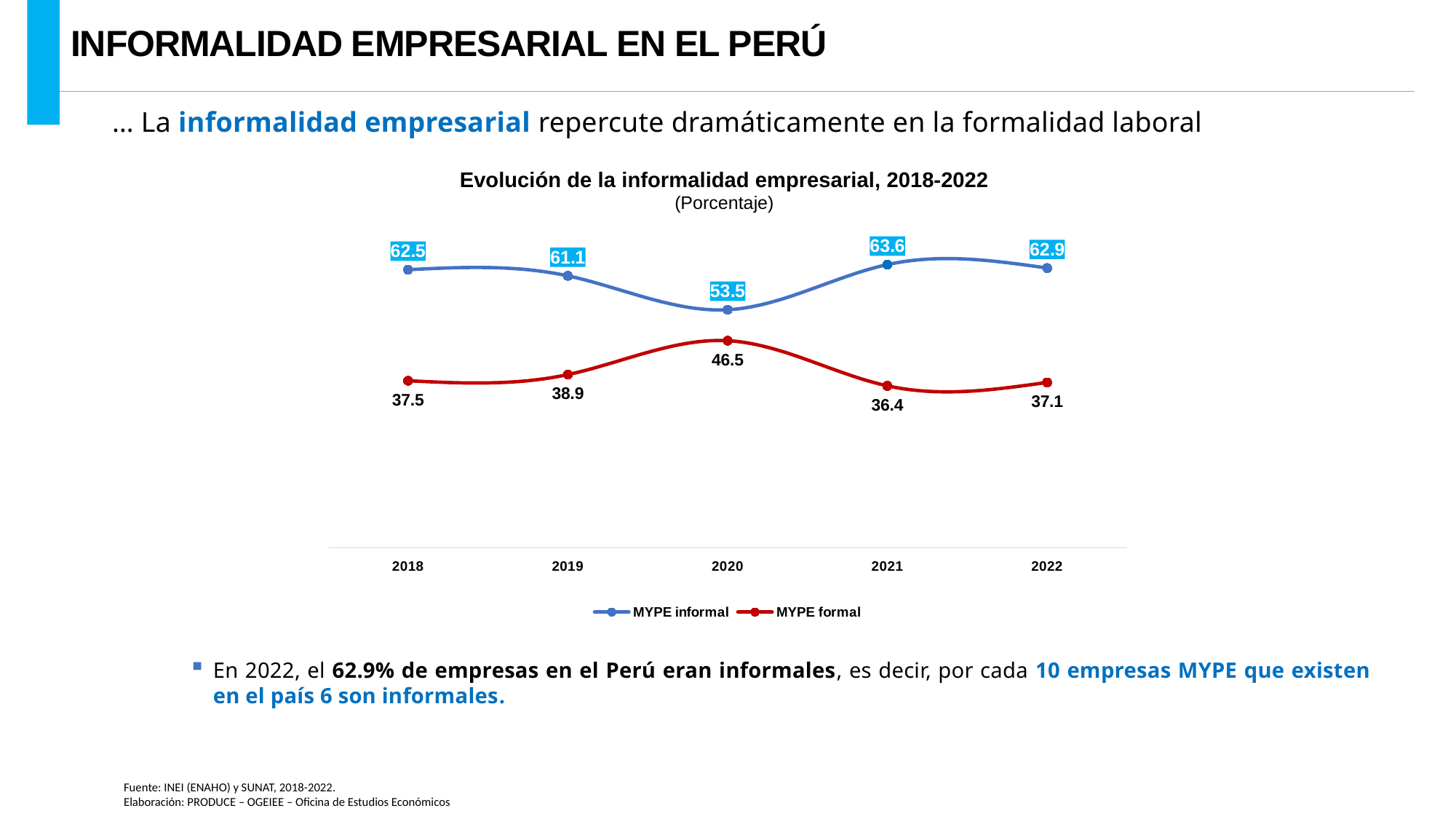
In which year was the MYPE informal value highest? 2021 How many series does the legend list? 2 What was the MYPE formal value in 2021? 36.4 How many years are shown on the x axis? 5 What was the MYPE informal value in 2020? 53.5 Which series had the larger value in 2018, MYPE informal or MYPE formal? MYPE informal Did the MYPE formal value rise or fall from 2019 to 2020? Rise What was the MYPE informal value in 2022? 62.9 What is the difference between the MYPE informal and MYPE formal values in 2020? 7 In which year was the MYPE formal value lowest? 2021 What is the title of the chart? Evolución de la informalidad empresarial, 2018-2022 What kind of chart is shown on the slide? Line chart